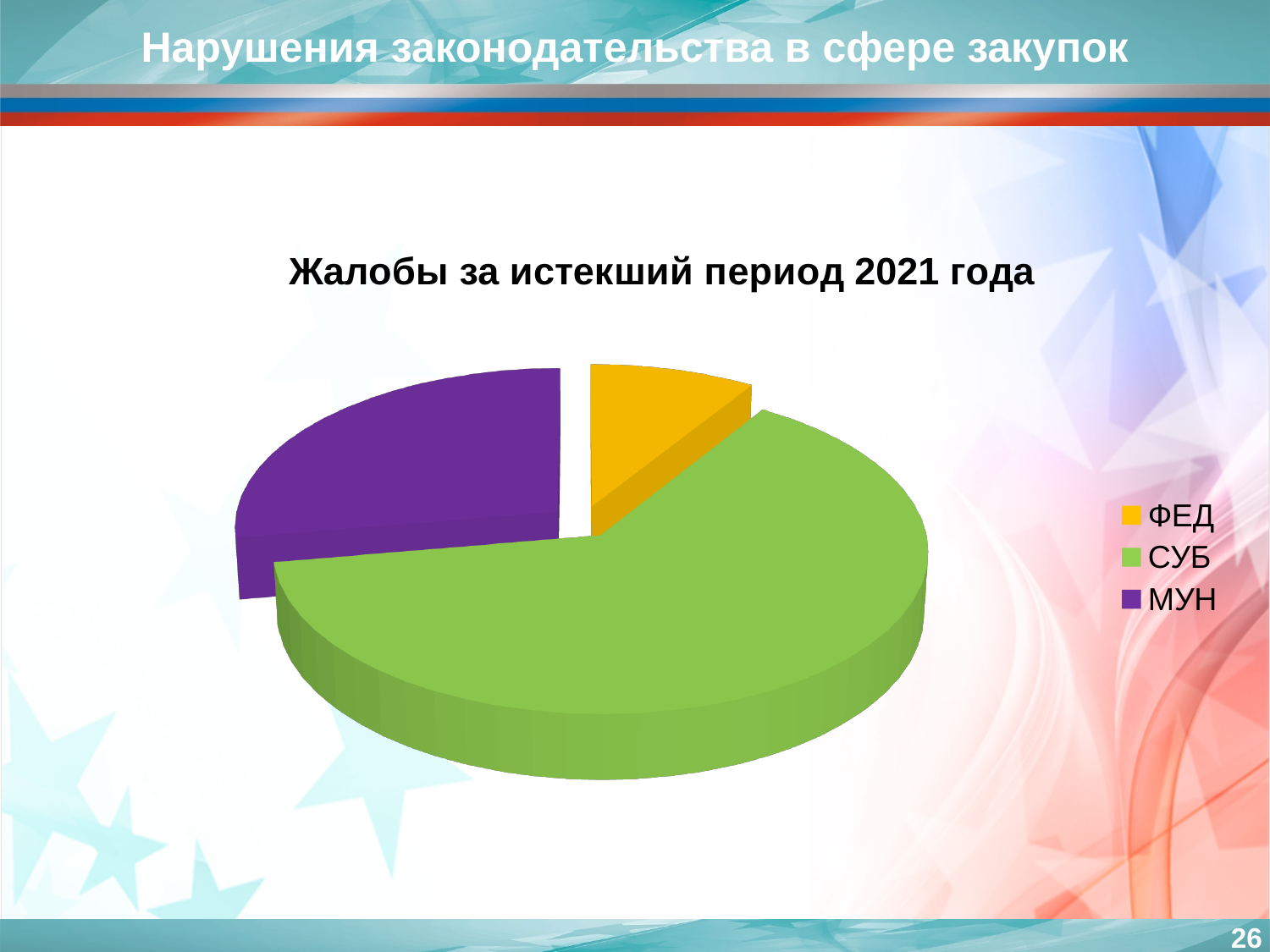
What colour is the СУБ slice in the pie chart? green How many slices does the pie chart have? 3 Which slice is larger, МУН or ФЕД? МУН Which category has the smallest slice of the pie? ФЕД What is the title of the chart? Жалобы за истекший период 2021 года How many entries does the legend list? 3 Which category has the largest slice of the pie? СУБ Which slice is larger, СУБ or МУН? СУБ What kind of chart is shown on the slide? pie chart